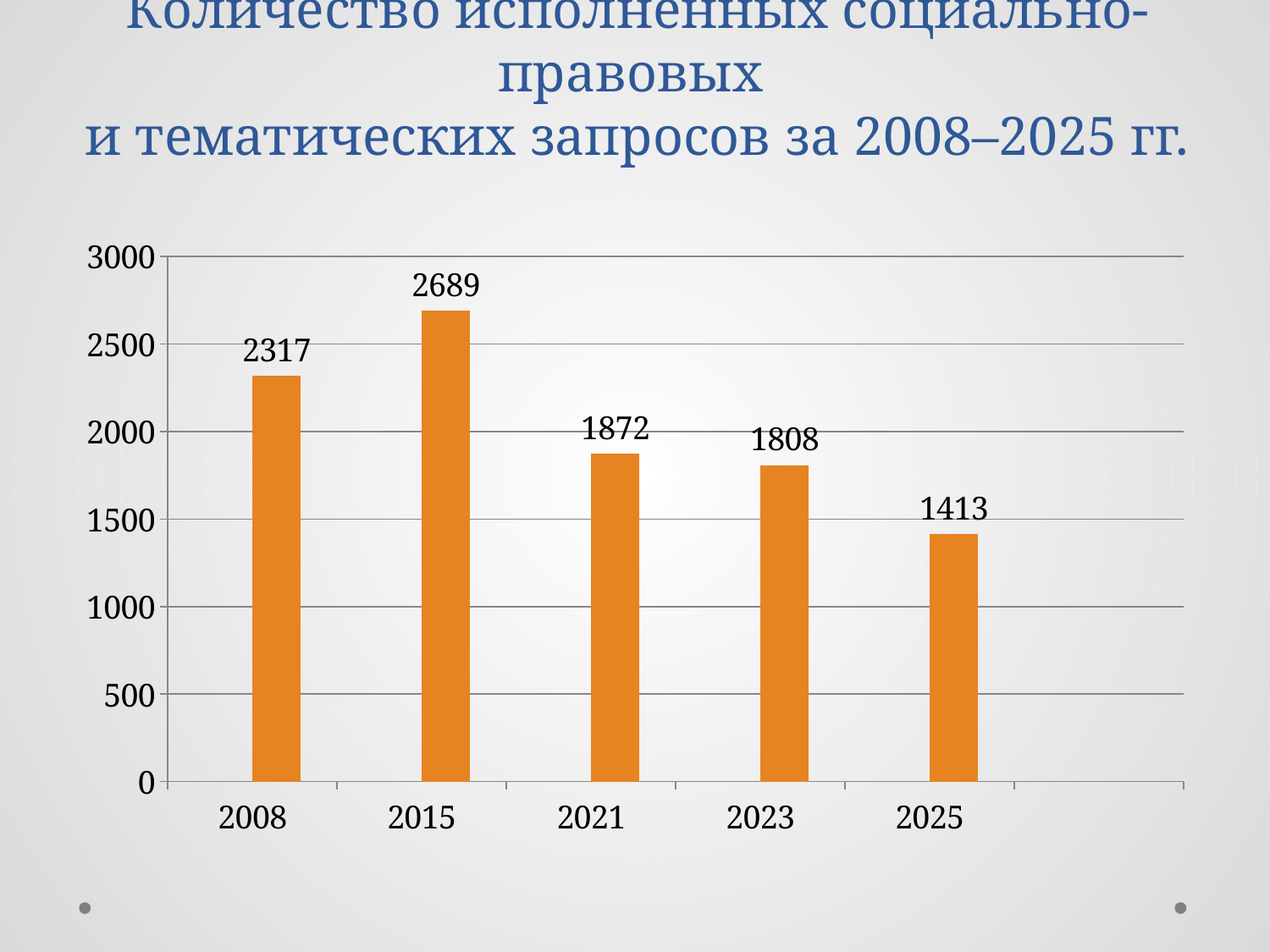
What is the value for 2015? 2689 Which year has the lowest value? 2025 Which is larger, the value for 2021 or the value for 2023? 2021 What is the difference between the values for 2015 and 2008? 372 What is the value for 2021? 1872 What kind of chart is this? bar chart What is the value for 2008? 2317 What is the difference between the values for 2023 and 2025? 395 How many years are shown on the x axis? 5 What is the value for 2025? 1413 Which year has the highest value? 2015 Do the values rise or fall from 2015 to 2025? fall